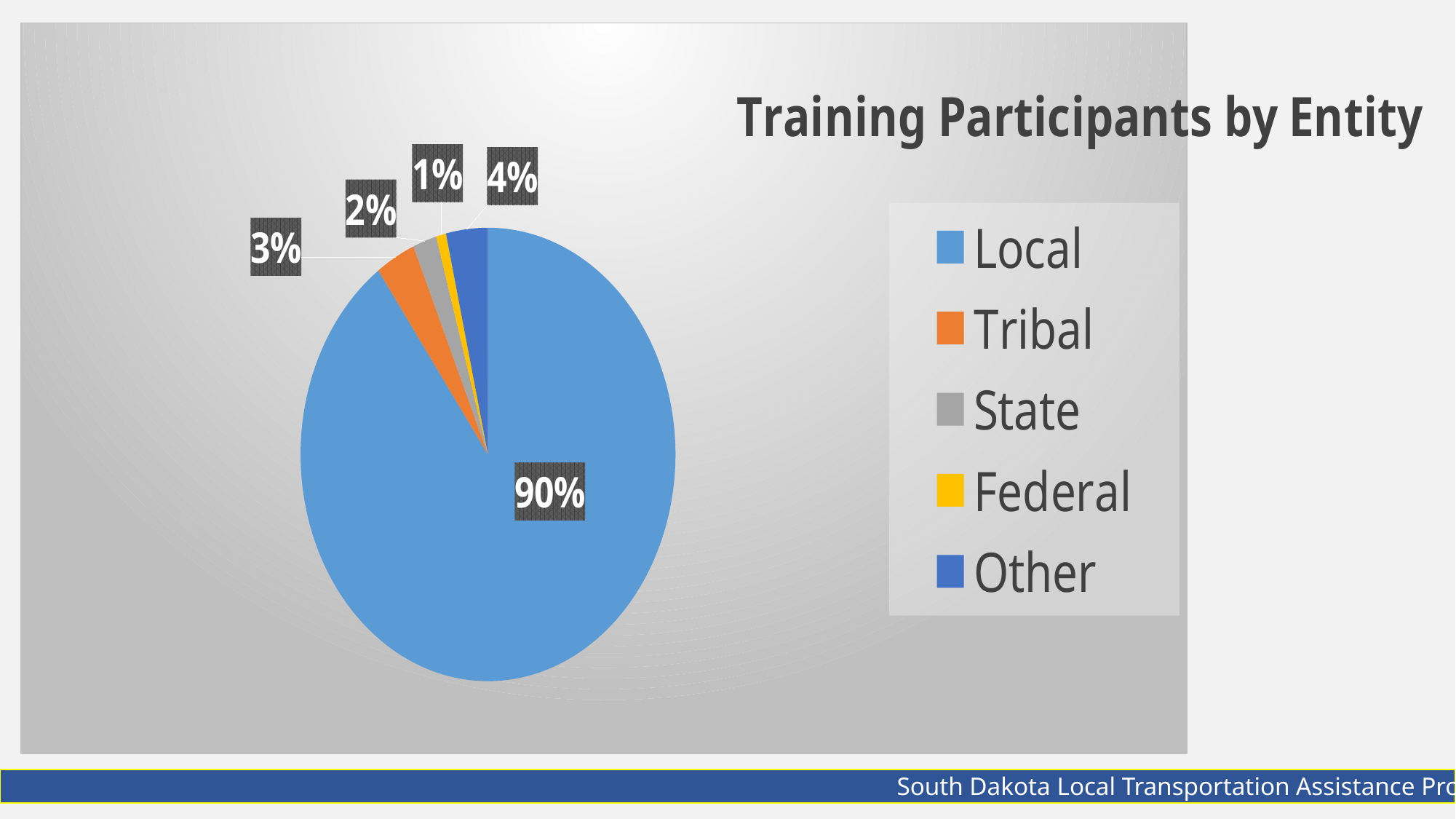
What share of training participants are Local? 90% What is the title of the chart? Training Participants by Entity What share of training participants are Other? 4% What type of chart is shown on the slide? pie chart What is the difference in percentage points between the Local share and the Other share? 86 What share of training participants are Federal? 1% Which entity has the largest share of training participants? Local How many entity categories does the legend list? 5 Which has a larger share, Tribal or Other? Other Which entity has the smallest share of training participants? Federal What share of training participants are State? 2% What share of training participants are Tribal? 3%